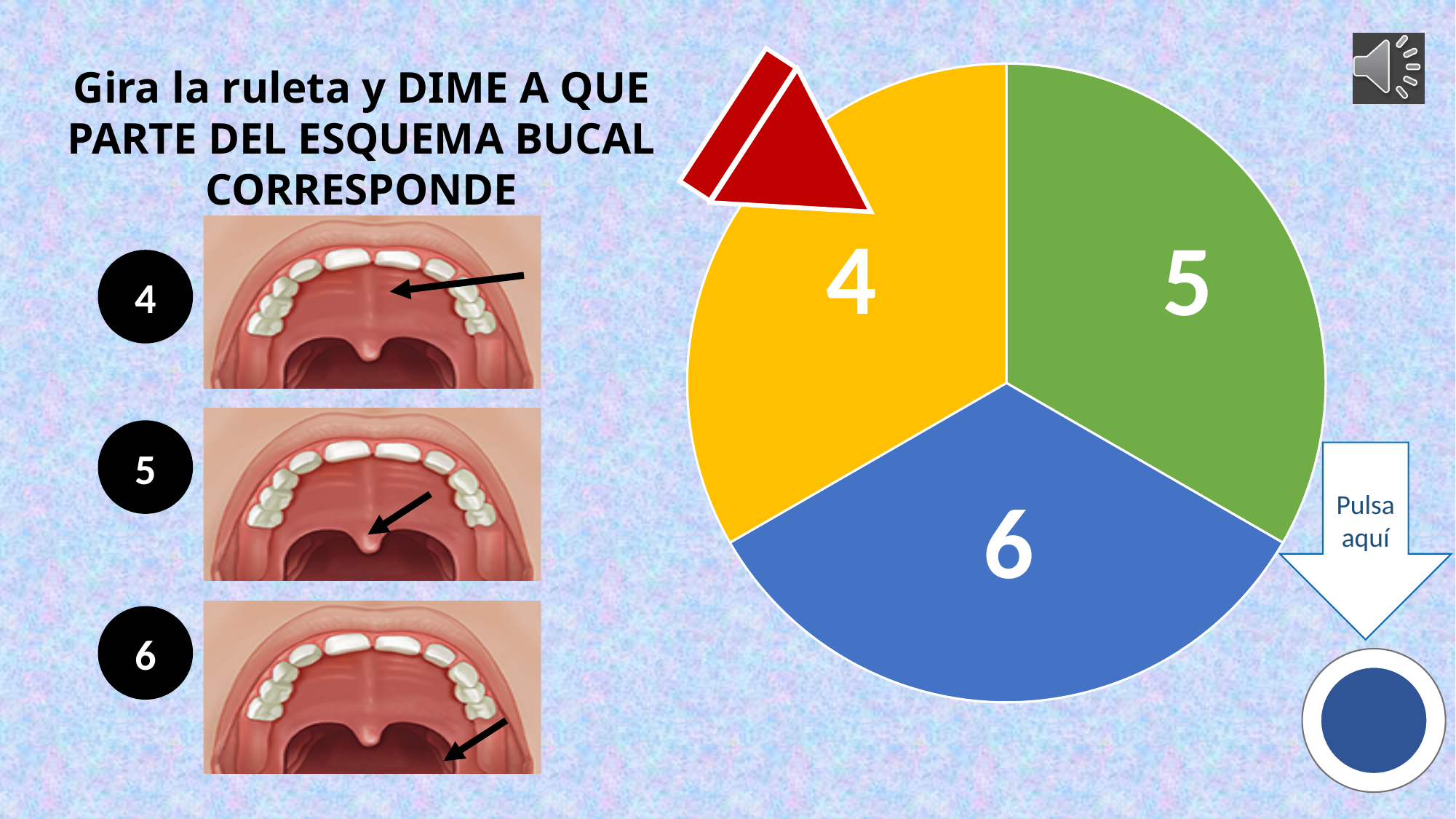
What colour is the slice labelled 4 in the pie chart? yellow Which slice of the pie chart is green? 5 How many slices does the pie chart have? 3 What labels appear on the slices of the pie chart? 4, 5, 6 Which slice of the pie chart is blue? 6 What kind of chart is used as the roulette wheel on the slide? pie chart